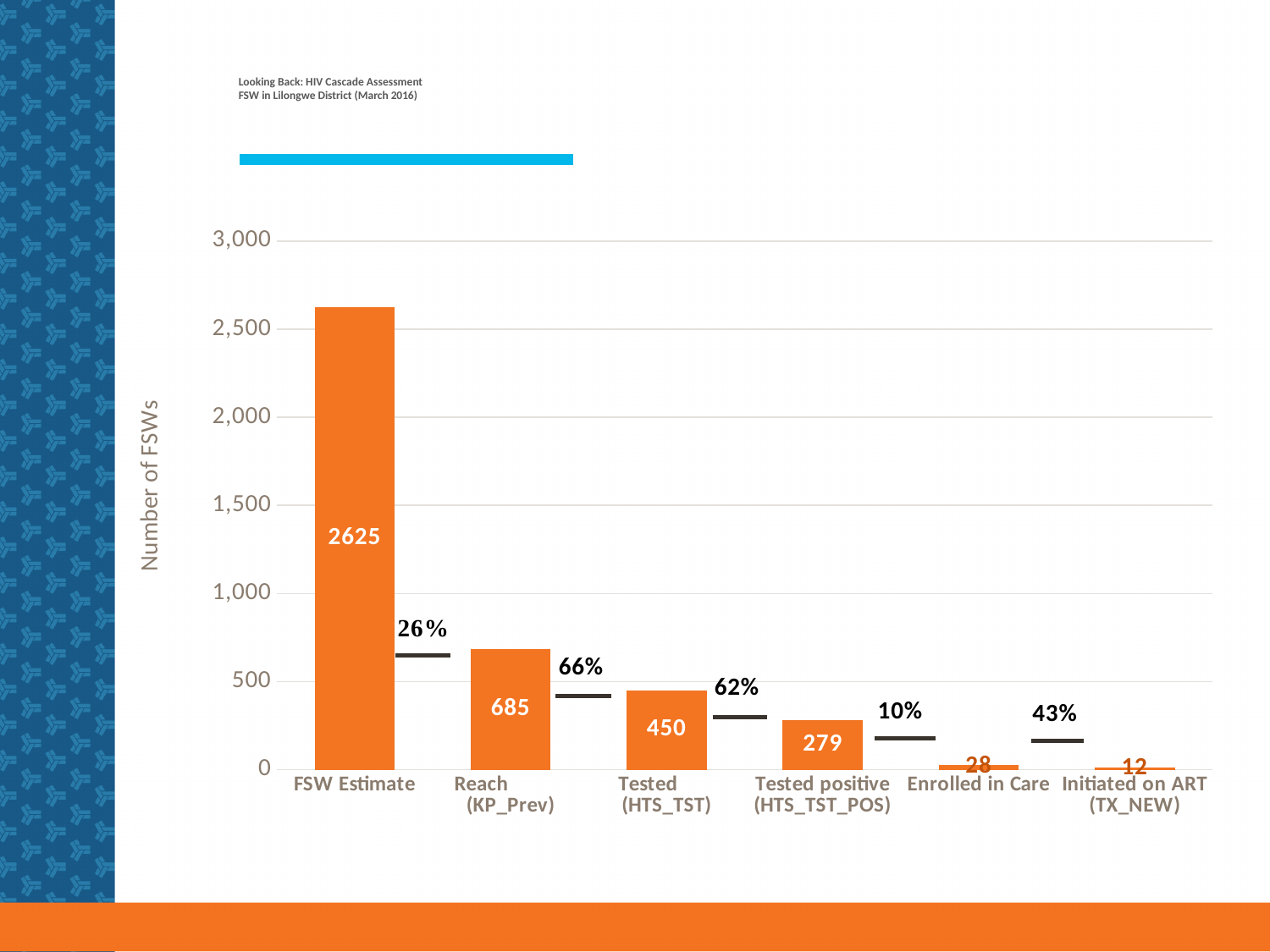
What kind of chart is shown on the slide? bar chart What is the value for Initiated on ART (TX_NEW)? 12 How many categories are shown on the x axis? 6 What is the value for Tested positive (HTS_TST_POS)? 279 What is the value for Reach (KP_Prev)? 685 Which category has the highest value? FSW Estimate What is the label of the y axis? Number of FSWs What is the value for FSW Estimate? 2625 Which category has the lowest value? Initiated on ART (TX_NEW) Which is larger, the value for Reach (KP_Prev) or the value for Tested (HTS_TST)? Reach (KP_Prev) Is the value for FSW Estimate greater or less than 2,500? greater What is the difference between the values for Tested (HTS_TST) and Tested positive (HTS_TST_POS)? 171